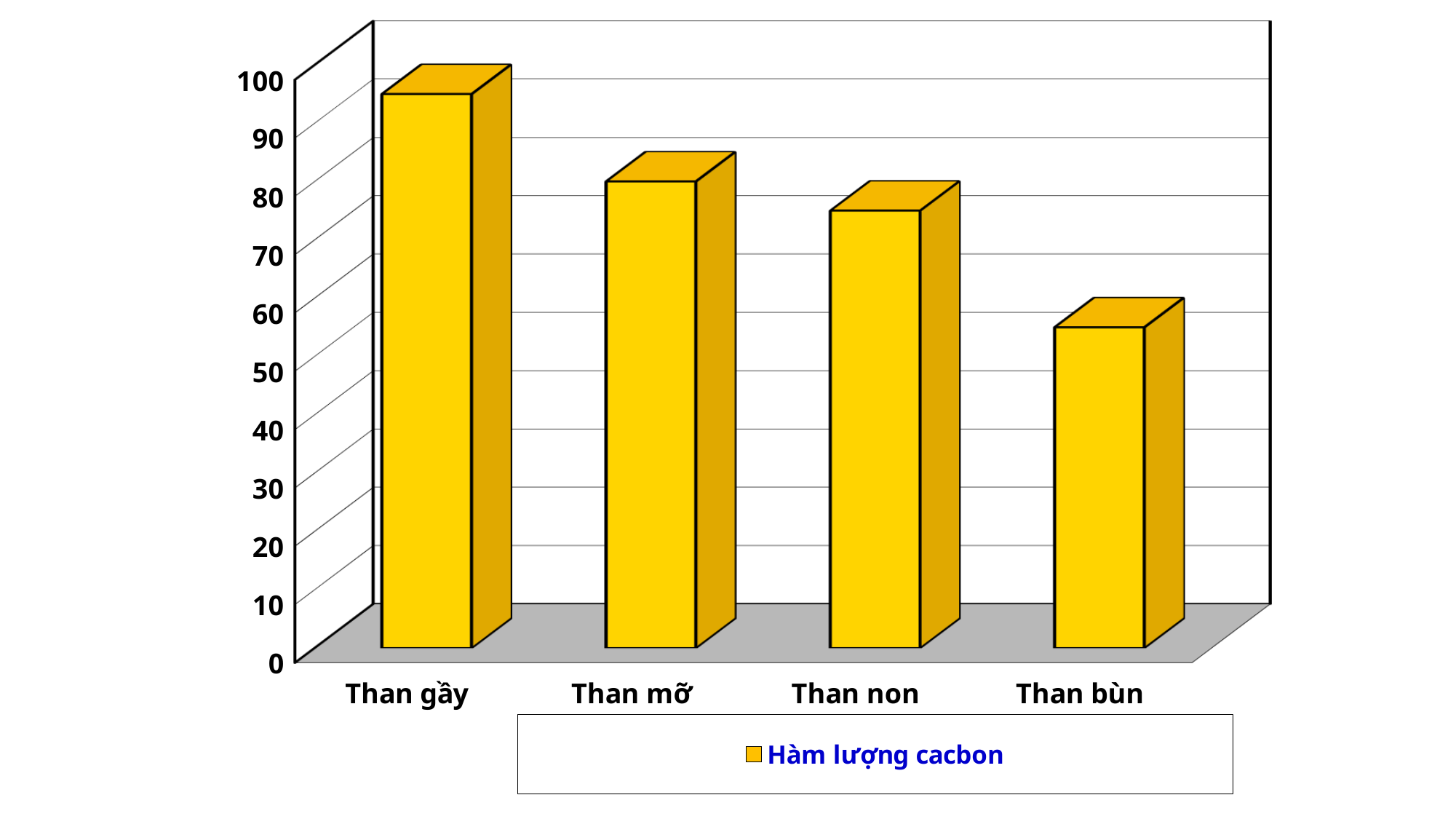
What is the name of the series shown in the legend? Hàm lượng cacbon Do the values rise or fall from Than gầy to Than bùn along the x axis? fall Which is larger, the value for Than gầy or the value for Than non? Than gầy How many series does the legend list? 1 Which category has the highest value? Than gầy Is the value for Than non greater or less than 60? greater How many categories are shown on the x axis? 4 What kind of chart is shown on the slide? bar chart Which category has the lowest value? Than bùn Which is larger, the value for Than mỡ or the value for Than bùn? Than mỡ Is the value for Than gầy greater or less than 80? greater Is the value for Than bùn greater or less than 70? less